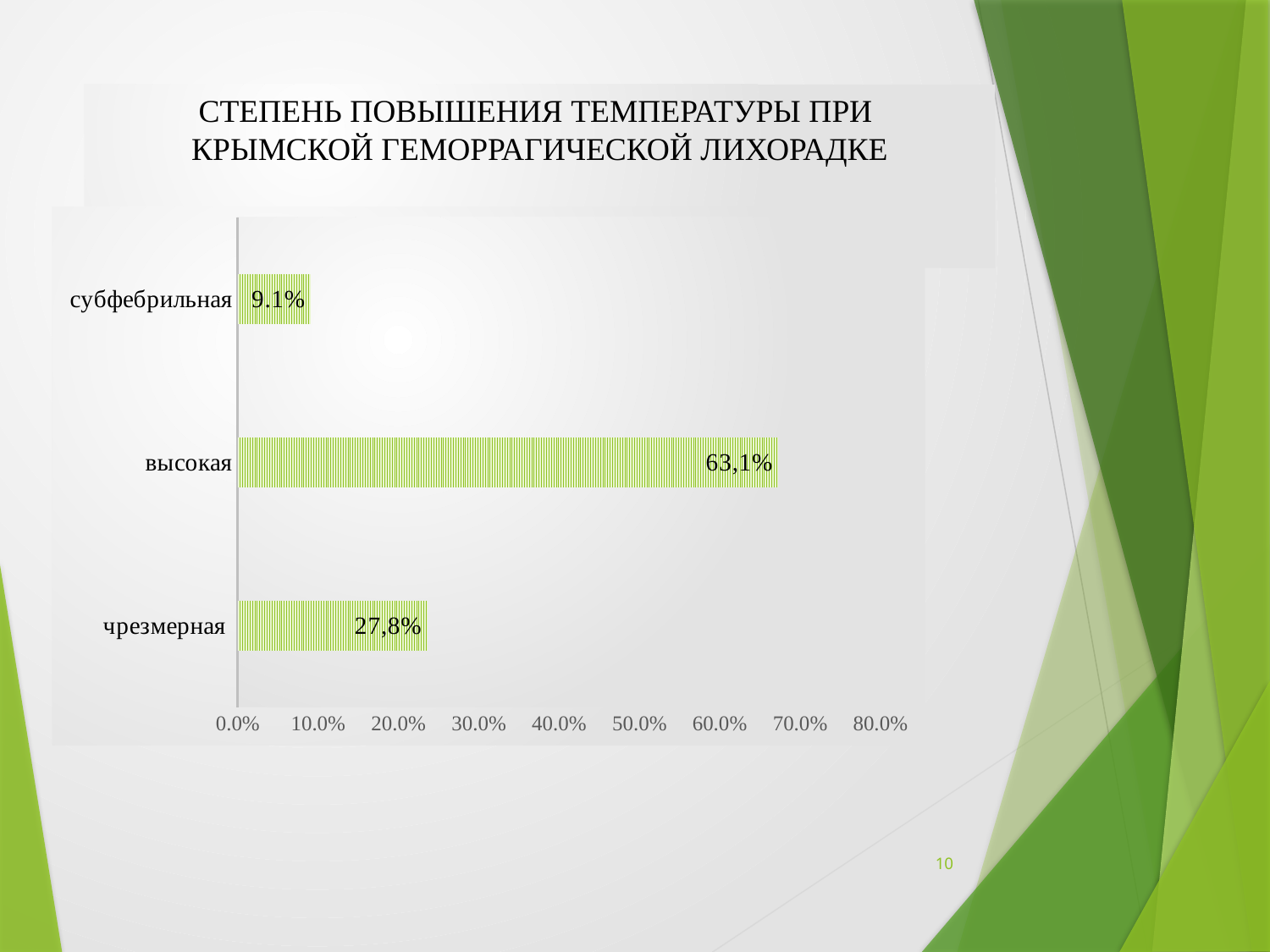
How many categories are shown in the chart? 3 Is the value for высокая greater or less than 50%? greater What is the value for высокая? 63,1% Which category has the highest value? высокая What kind of chart is shown on the slide? bar chart What is the difference between the values for высокая and чрезмерная? 35,3% What is the value for чрезмерная? 27,8% Which category has the lowest value? субфебрильная Which is larger, the value for чрезмерная or the value for субфебрильная? чрезмерная What is the title of the chart on the slide? СТЕПЕНЬ ПОВЫШЕНИЯ ТЕМПЕРАТУРЫ ПРИ КРЫМСКОЙ ГЕМОРРАГИЧЕСКОЙ ЛИХОРАДКЕ Is the value for чрезмерная greater or less than 40%? less What is the value for субфебрильная? 9.1%